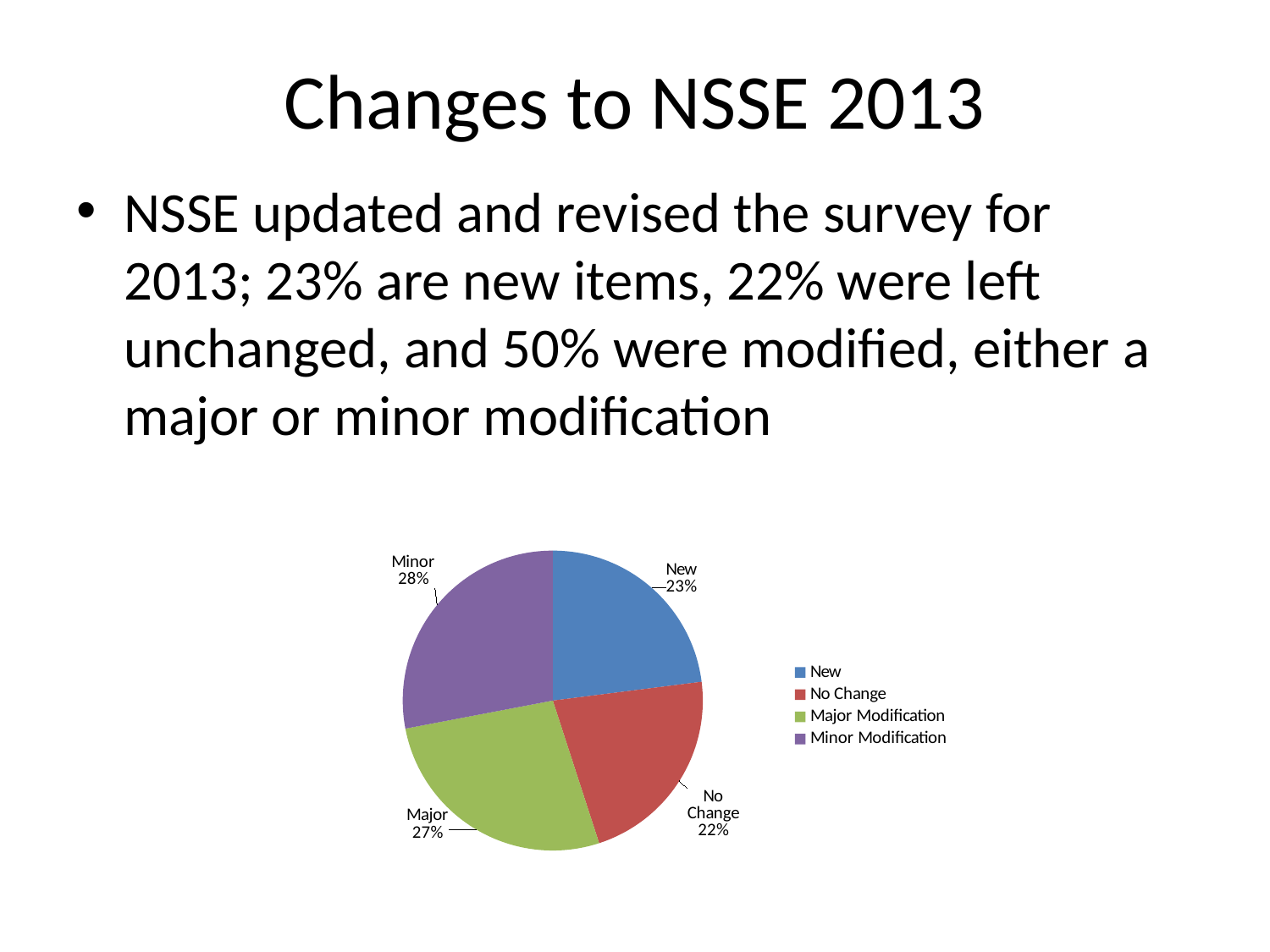
What kind of chart is shown on the slide? pie chart What percentage of the pie is the Minor slice? 28% Which is larger, the Major slice or the No Change slice? Major How many entries does the legend list? 4 Which slice of the pie chart is the smallest? No Change What colour is the No Change slice in the pie chart? red Which slice of the pie chart is the largest? Minor What percentage of the pie is the Major slice? 27% What is the difference in percentage points between the Minor slice and the New slice? 5 What percentage of the pie is the New slice? 23% What percentage of the pie is the No Change slice? 22% How many slices does the pie chart have? 4